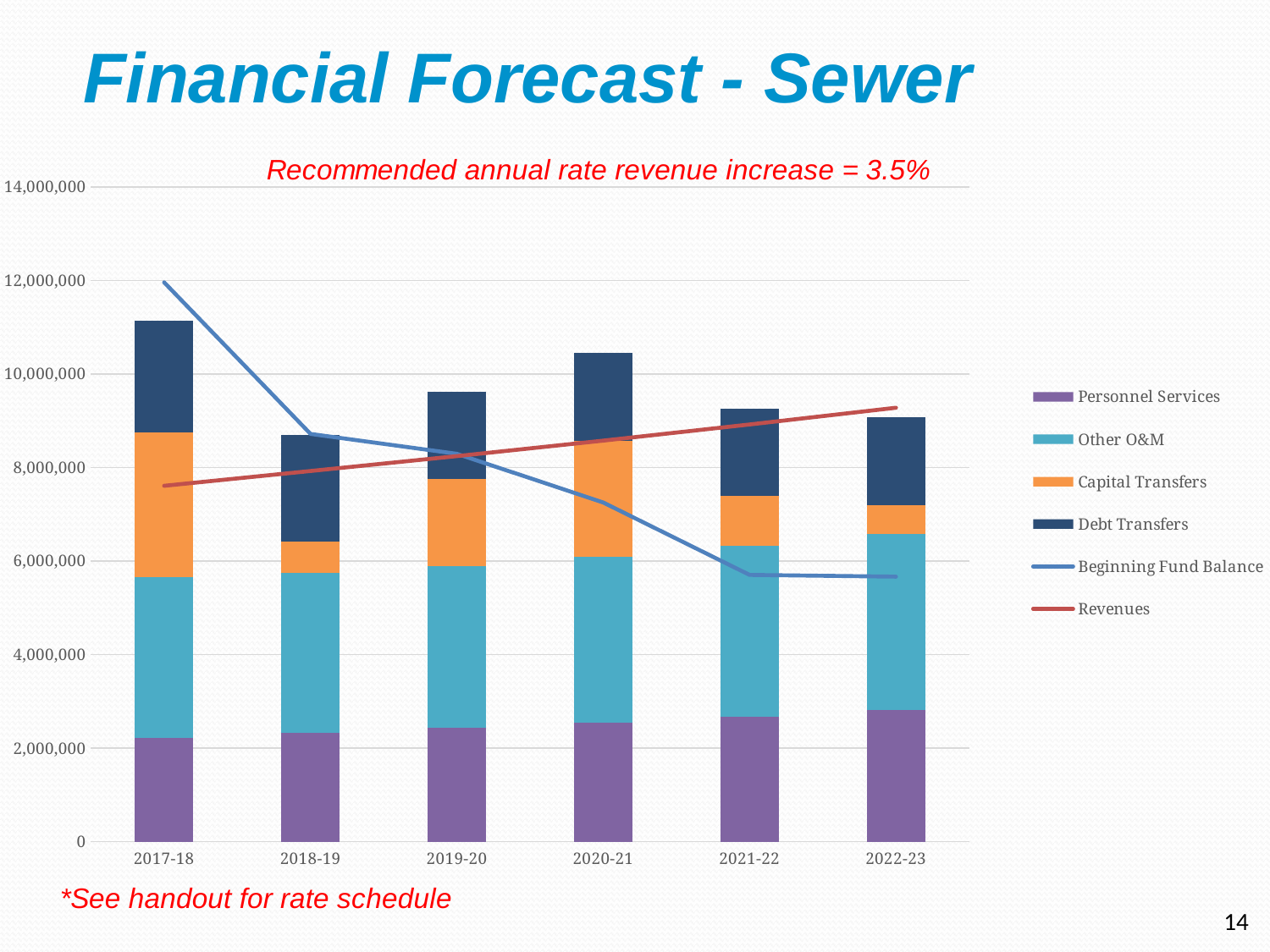
In 2017-18, which is larger: the Beginning Fund Balance or Revenues? Beginning Fund Balance Which fiscal year has the shortest stacked bar? 2018-19 Is the total height of the stacked bar for 2018-19 greater or less than 10,000,000? less How many series does the chart's legend list? 6 Does the Revenues line rise or fall from 2017-18 to 2022-23? Rises What recommended annual rate revenue increase is stated above the chart? 3.5% What kind of chart is shown on the slide? A stacked bar chart with line series Which fiscal year has the tallest stacked bar? 2017-18 Is the Beginning Fund Balance for 2021-22 greater or less than 6,000,000? less Does the Beginning Fund Balance line rise or fall from 2017-18 to 2021-22? Falls How many fiscal years are shown on the x axis of the chart? 6 Is the Beginning Fund Balance for 2017-18 greater or less than 10,000,000? greater